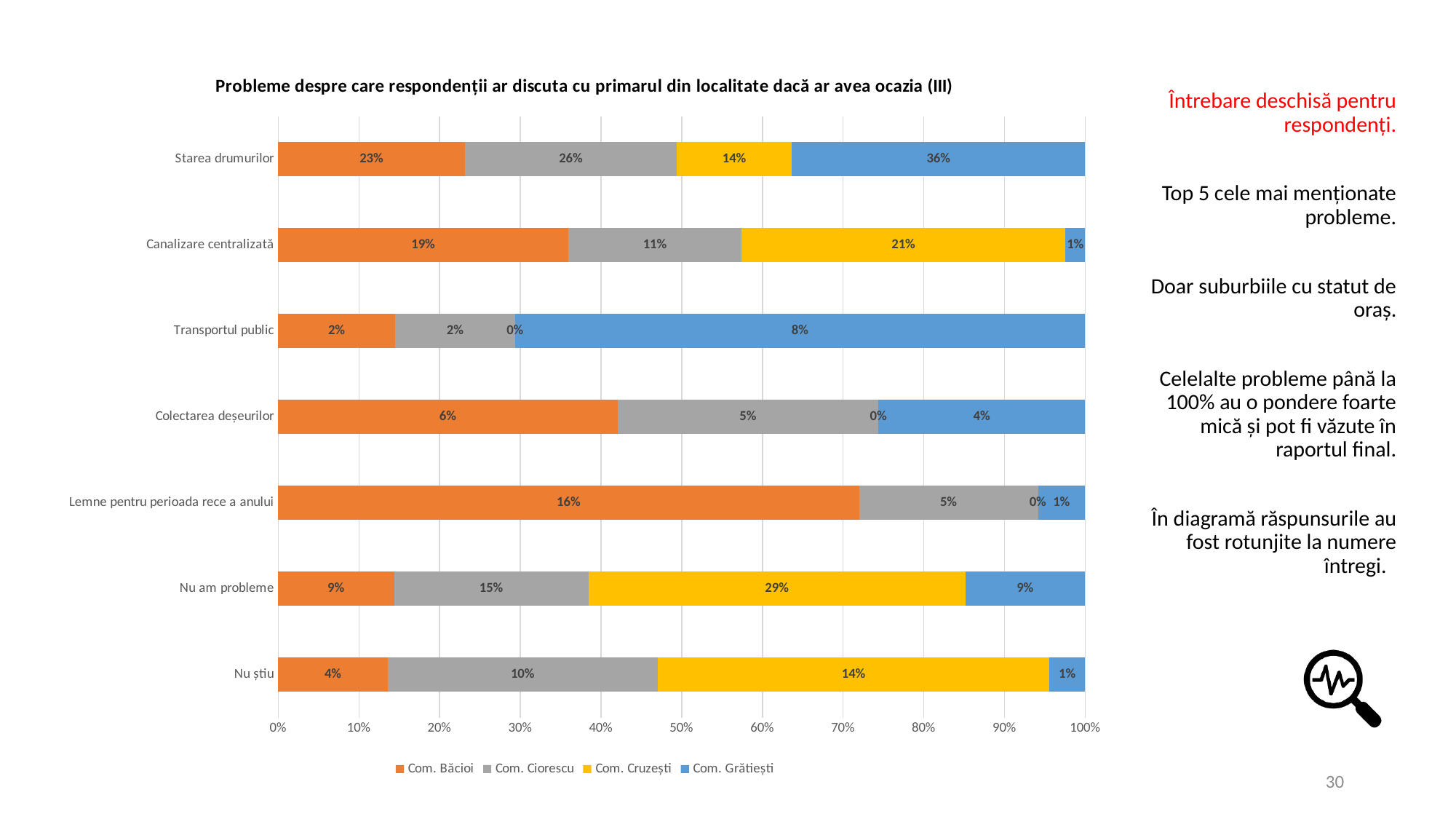
What is the value for Com. Băcioi for Lemne pentru perioada rece a anului? 16% How many categories are shown on the chart? 7 For Canalizare centralizată, which is larger: the value for Com. Băcioi or the value for Com. Cruzești? Com. Cruzești What is the difference between the Com. Cruzești value and the Com. Băcioi value for Nu știu? 10% How many series does the legend list? 4 What is the value for Com. Grătiești for Starea drumurilor? 36% Which category has the lowest value for Com. Ciorescu? Transportul public Which series is shown in orange in the legend? Com. Băcioi What is the value for Com. Cruzești for Nu am probleme? 29% What kind of chart is shown on the slide? bar chart Which category has the highest value for Com. Băcioi? Starea drumurilor What is the value for Com. Ciorescu for Canalizare centralizată? 11%